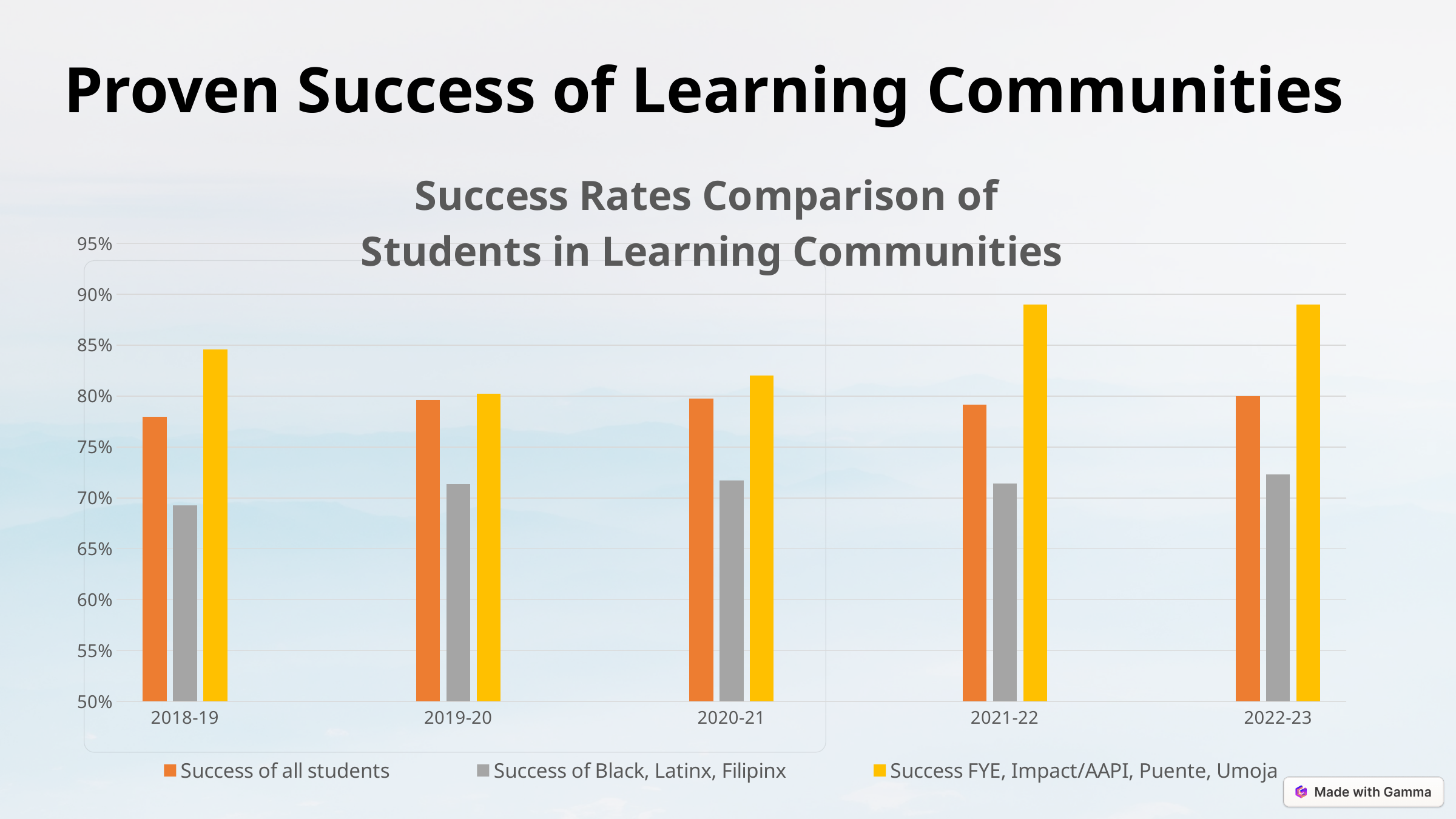
How many academic years are shown on the x axis? 5 In 2021-22, which series has the highest value? Success FYE, Impact/AAPI, Puente, Umoja How many series does the legend list? 3 Is the value for Success of all students in 2018-19 greater or less than 80%? less Which series is shown in yellow? Success FYE, Impact/AAPI, Puente, Umoja What kind of chart is shown on the slide? bar chart In which year is the Success FYE, Impact/AAPI, Puente, Umoja value lowest? 2019-20 Is the value for Success FYE, Impact/AAPI, Puente, Umoja in 2021-22 greater or less than 85%? greater Is the value for Success of Black, Latinx, Filipinx in 2018-19 greater or less than 70%? less What is the title of the chart? Success Rates Comparison of Students in Learning Communities In which year is the Success of Black, Latinx, Filipinx value lowest? 2018-19